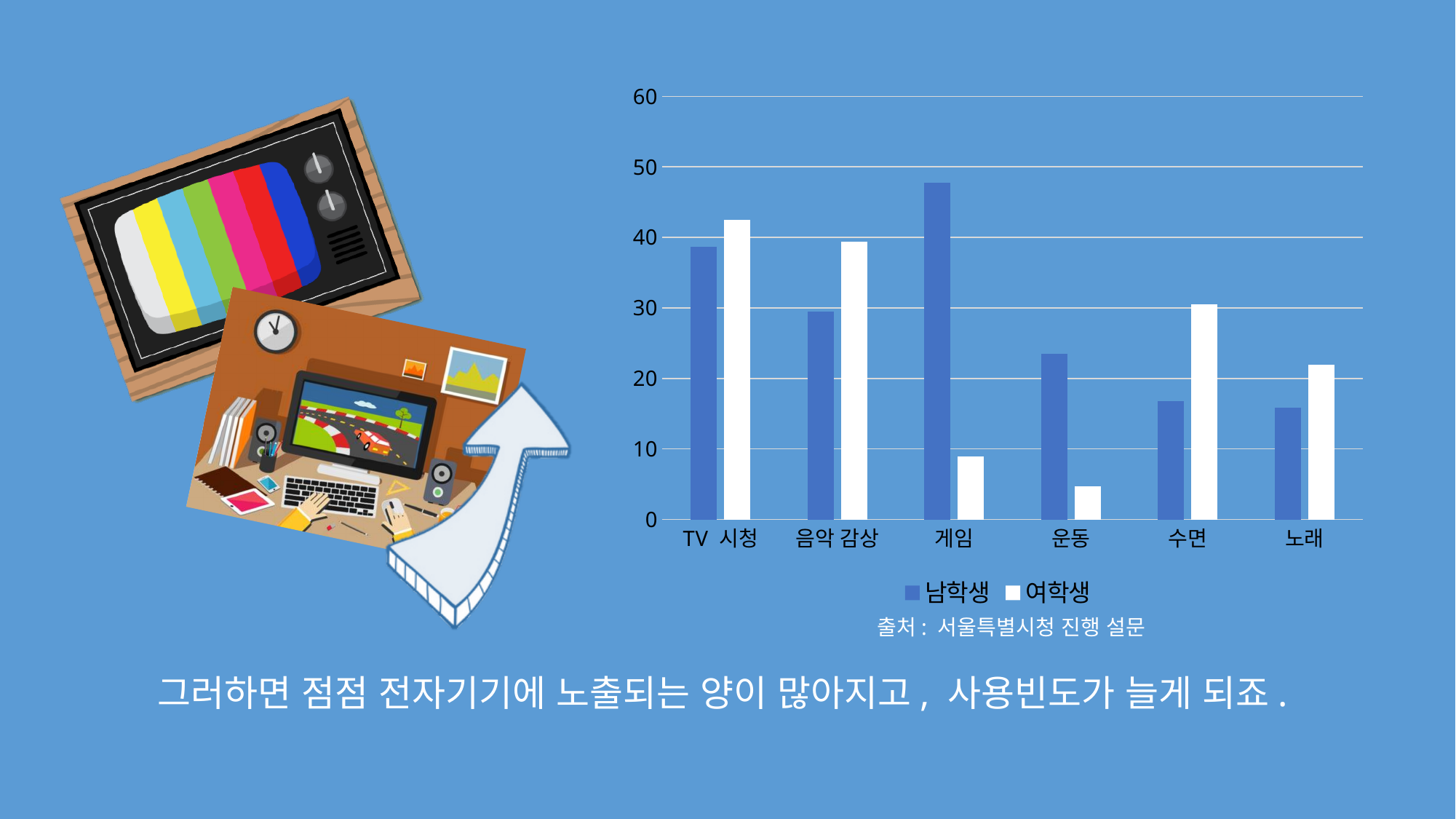
Is the value for 여학생 in 수면 greater or less than 20? greater In the 수면 category, which series has the larger value, 남학생 or 여학생? 여학생 How many categories are shown on the x axis of the chart? 6 Which category has the highest value for 남학생? 게임 Is the value for 남학생 in 게임 greater or less than 40? greater Is the value for 여학생 in 운동 greater or less than 10? less In the 게임 category, which series has the larger value, 남학생 or 여학생? 남학생 How many series does the chart's legend list? 2 What kind of chart is shown on the slide? bar chart Which category has the lowest value for 여학생? 운동 Which series is shown in white bars in the chart? 여학생